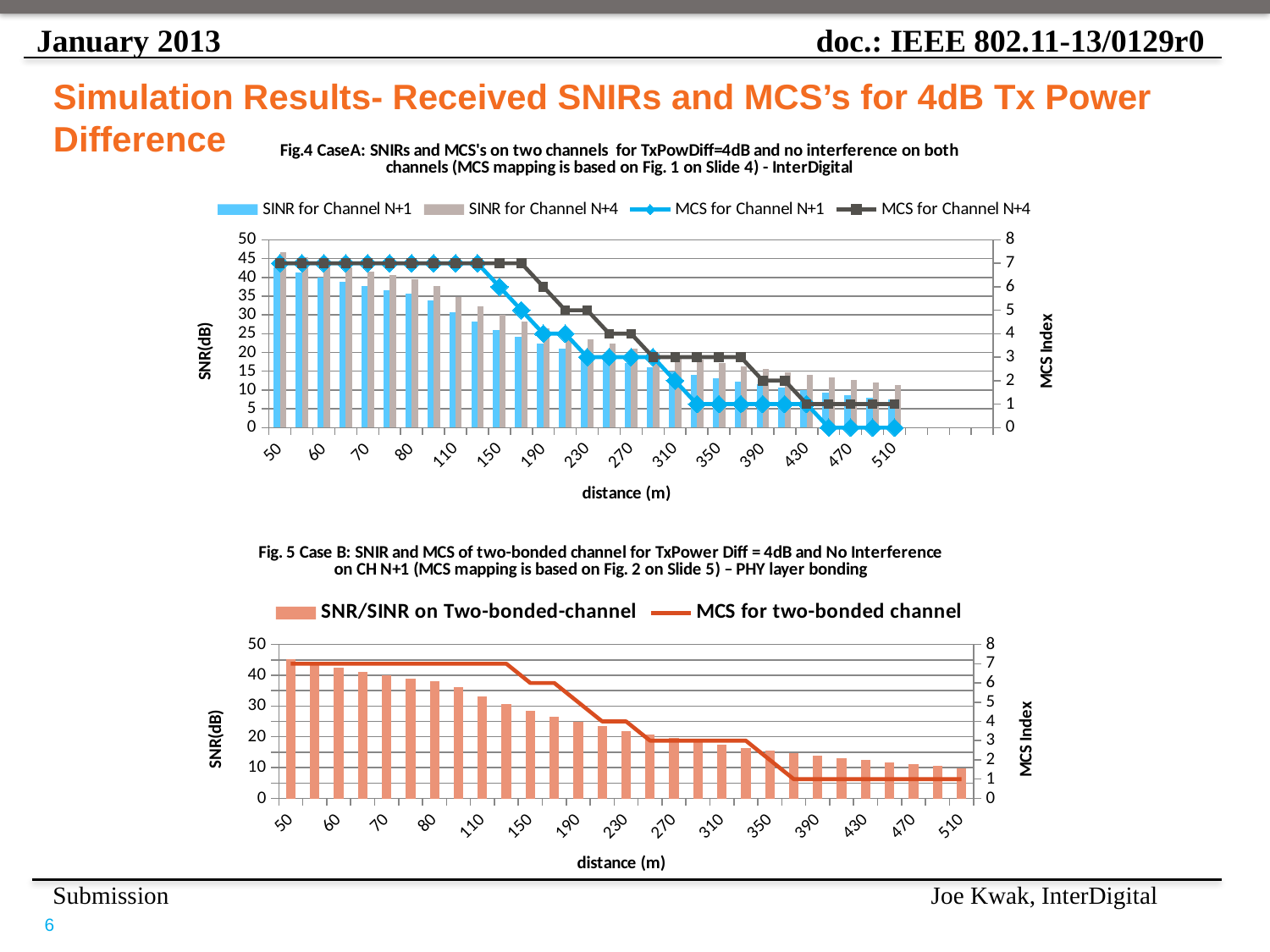
On the top chart (Fig.4 Case A), how many series does the legend list? 4 On the top chart (Fig.4 Case A), what is the MCS for Channel N+1 at a distance of 50 m? 7 On the top chart (Fig.4 Case A), what is the title of the right-hand vertical axis? MCS Index What kind of chart is the bottom chart (Fig. 5 Case B)? Combination bar and line chart On the top chart (Fig.4 Case A), what is the MCS for Channel N+1 at a distance of 510 m? 0 On the top chart (Fig.4 Case A), what is the MCS for Channel N+4 at a distance of 510 m? 1 On the top chart (Fig.4 Case A), at 190 m, which is larger: the MCS for Channel N+1 or the MCS for Channel N+4? MCS for Channel N+4 On the bottom chart (Fig. 5 Case B), is the SNR/SINR on Two-bonded-channel at 390 m greater or less than 20? less On the bottom chart (Fig. 5 Case B), what is the MCS for two-bonded channel at a distance of 50 m? 7 On the bottom chart (Fig. 5 Case B), do the SNR/SINR on Two-bonded-channel values rise or fall as distance increases? fall On the top chart (Fig.4 Case A), is the SINR for Channel N+4 at 50 m greater or less than 40? greater On the bottom chart (Fig. 5 Case B), how many series does the legend list? 2